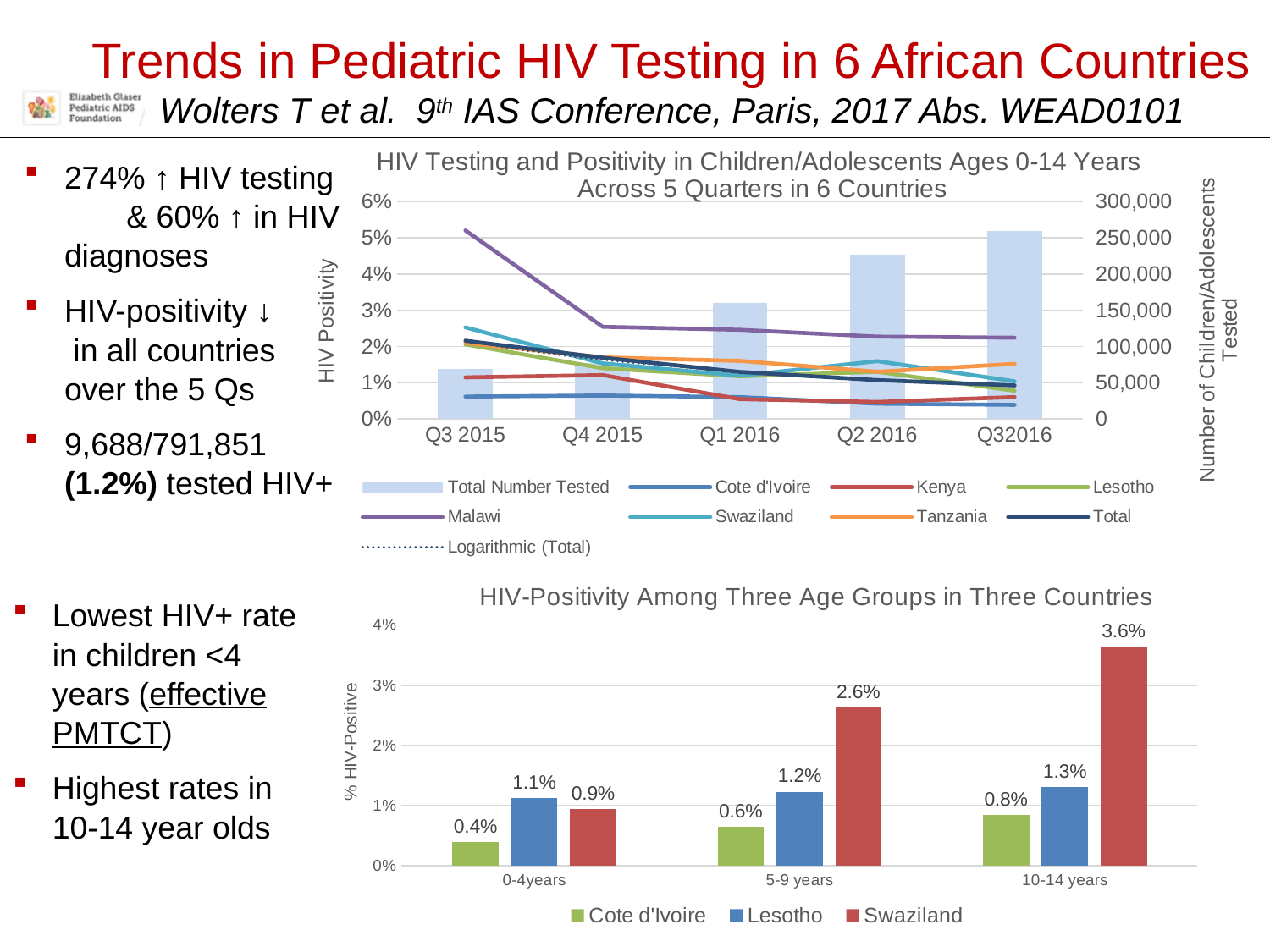
In the bottom chart 'HIV-Positivity Among Three Age Groups in Three Countries', which country has the highest HIV-positivity in the 10-14 years group? Swaziland In the bottom chart 'HIV-Positivity Among Three Age Groups in Three Countries', how does Swaziland's HIV-positivity change as the age group increases from 0-4 years to 10-14 years? It rises In the bottom chart 'HIV-Positivity Among Three Age Groups in Three Countries', what is the value for Lesotho in the 5-9 years group? 1.2% In the bottom chart 'HIV-Positivity Among Three Age Groups in Three Countries', what is the value for Cote d'Ivoire in the 0-4 years group? 0.4% In the top chart 'HIV Testing and Positivity in Children/Adolescents Ages 0-14 Years Across 5 Quarters in 6 Countries', is the Total Number Tested in Q3 2015 greater or less than 100,000? less In the top chart 'HIV Testing and Positivity in Children/Adolescents Ages 0-14 Years Across 5 Quarters in 6 Countries', is the HIV positivity for Malawi in Q3 2015 greater or less than 5%? greater In the bottom chart 'HIV-Positivity Among Three Age Groups in Three Countries', what is the HIV-positivity for Swaziland in the 10-14 years group? 3.6% In the bottom chart 'HIV-Positivity Among Three Age Groups in Three Countries', what is the difference between Swaziland's value in the 10-14 years group and its value in the 5-9 years group? 1.0% In the bottom chart 'HIV-Positivity Among Three Age Groups in Three Countries', how many countries does the legend list? 3 In the bottom chart 'HIV-Positivity Among Three Age Groups in Three Countries', which is larger in the 0-4 years group: Lesotho or Swaziland? Lesotho In the top chart 'HIV Testing and Positivity in Children/Adolescents Ages 0-14 Years Across 5 Quarters in 6 Countries', how many quarters are shown on the x axis? 5 In the bottom chart 'HIV-Positivity Among Three Age Groups in Three Countries', which country has the lowest HIV-positivity in the 0-4 years group? Cote d'Ivoire